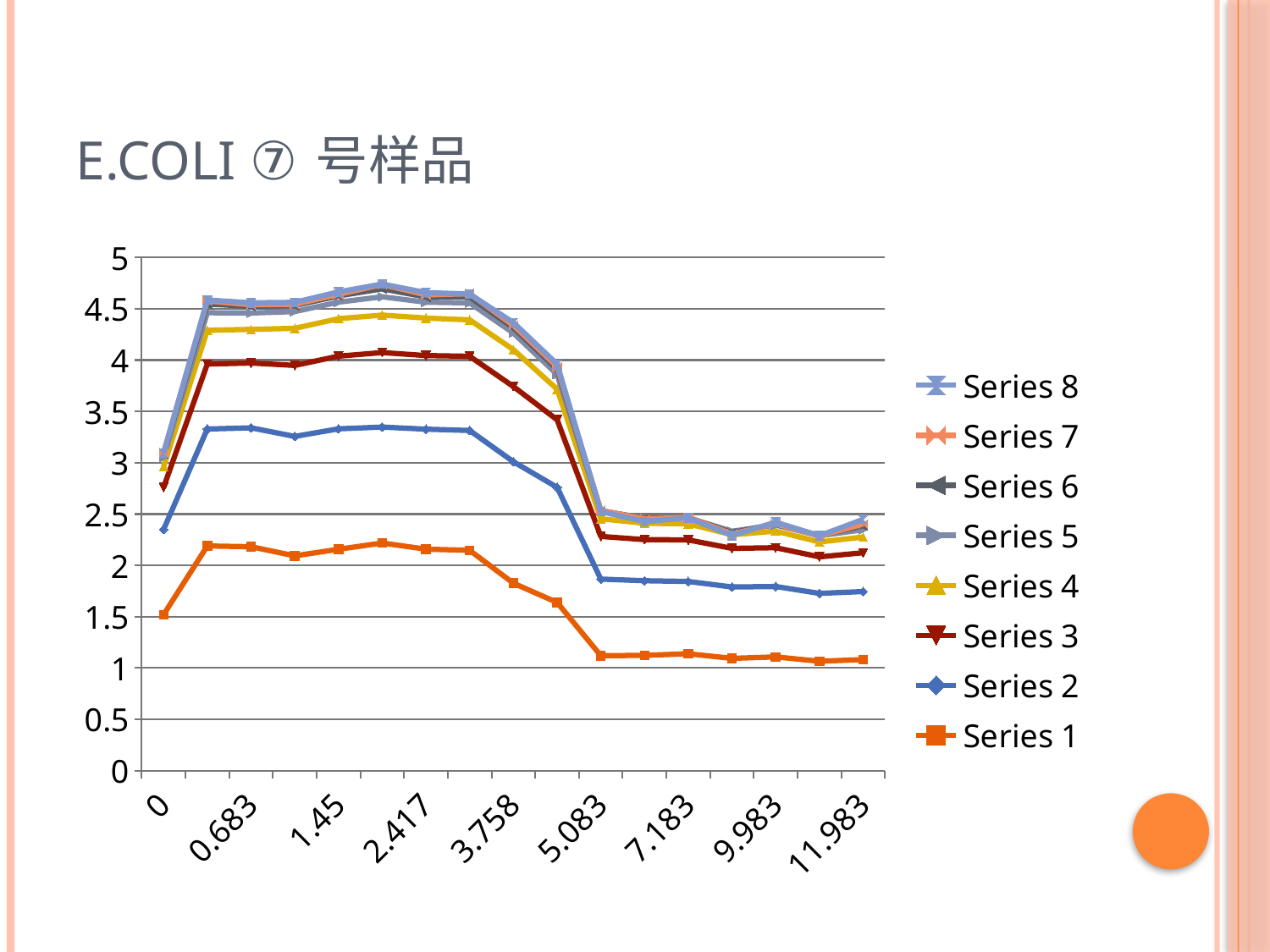
Is the value for Series 2 at x = 11.983 greater or less than 2? less Is the value for Series 2 at x = 0 greater or less than 2? greater What kind of chart is shown on the slide? line chart What is the title of the slide containing the chart? E.COLI ⑦ 号样品 How many series does the legend list? 8 Do the values for Series 1 rise or fall between x = 3.758 and x = 5.083? fall How many labels are shown on the x axis? 9 Which series is drawn in orange with square markers? Series 1 At x = 0, which is larger: Series 1 or Series 2? Series 2 Is the value for Series 4 at x = 0.683 greater or less than 4? greater Which series has the lowest values across the whole chart? Series 1